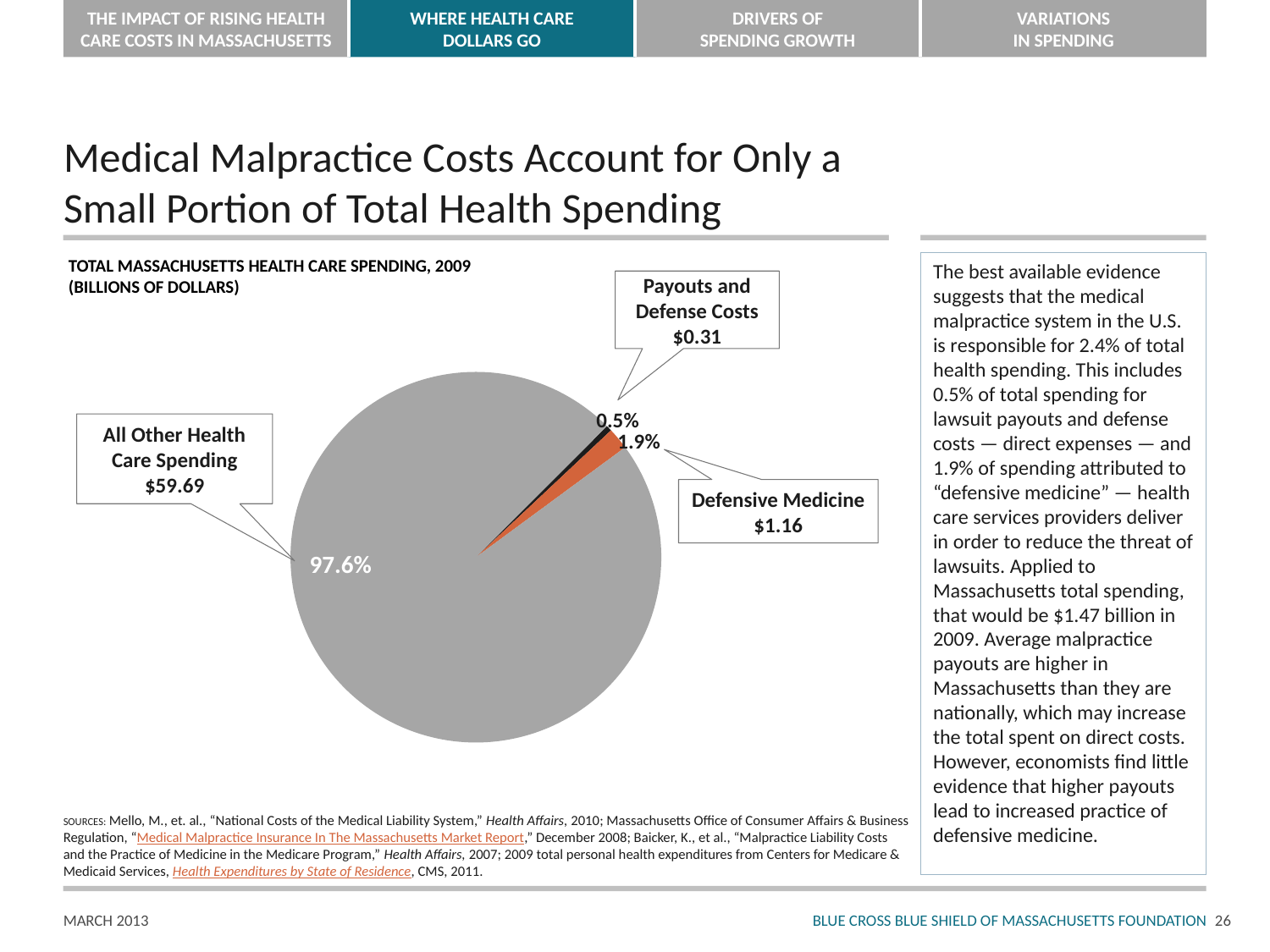
What is the title of the chart? Total Massachusetts Health Care Spending, 2009 (Billions of Dollars) What is the value for All Other Health Care Spending? $59.69 What share of the pie does Payouts and Defense Costs represent? 0.5% What is the value for Defensive Medicine? $1.16 Which category has the smallest slice of the pie? Payouts and Defense Costs What is the value for Payouts and Defense Costs? $0.31 What share of the pie does Defensive Medicine represent? 1.9% Which is larger, Defensive Medicine or Payouts and Defense Costs? Defensive Medicine What share of the pie does All Other Health Care Spending represent? 97.6% What is the difference between the Defensive Medicine value and the Payouts and Defense Costs value? $0.85 What kind of chart is shown on the slide? Pie chart How many slices does the pie chart have? 3